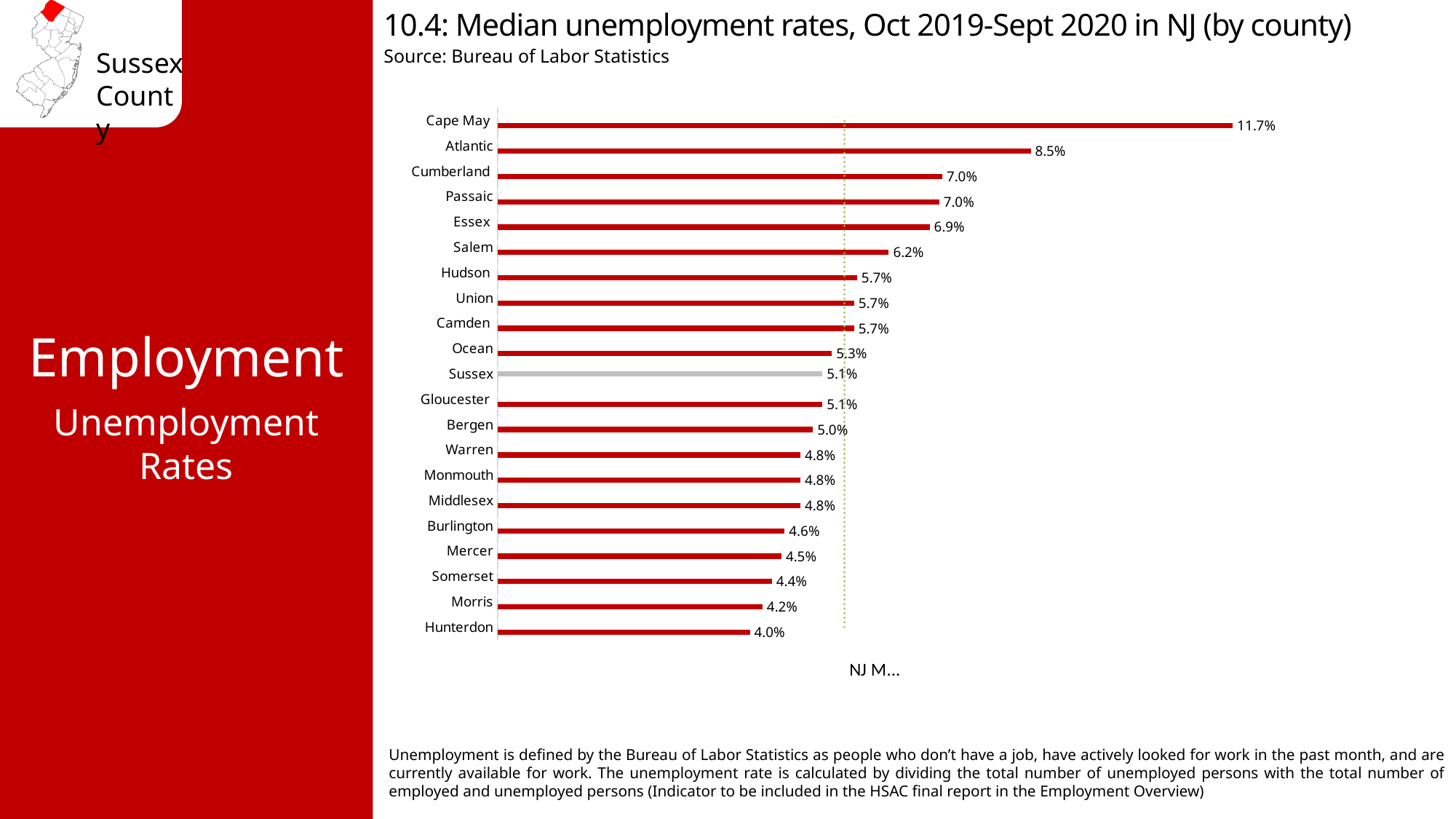
How many counties are shown in the chart? 21 What is the median unemployment rate for Sussex? 5.1% What is the median unemployment rate for Cape May? 11.7% Which county has the lowest median unemployment rate? Hunterdon Which county has a higher median unemployment rate, Essex or Ocean? Essex What is the median unemployment rate for Hunterdon? 4.0% Which county's bar is shown in grey instead of red? Sussex What kind of chart is used to show the median unemployment rates? Bar chart Which county has the highest median unemployment rate? Cape May What is the difference between the median unemployment rates of Cape May and Atlantic? 3.2% What is the median unemployment rate for Salem? 6.2% What is the difference between the median unemployment rates of Sussex and Hunterdon? 1.1%